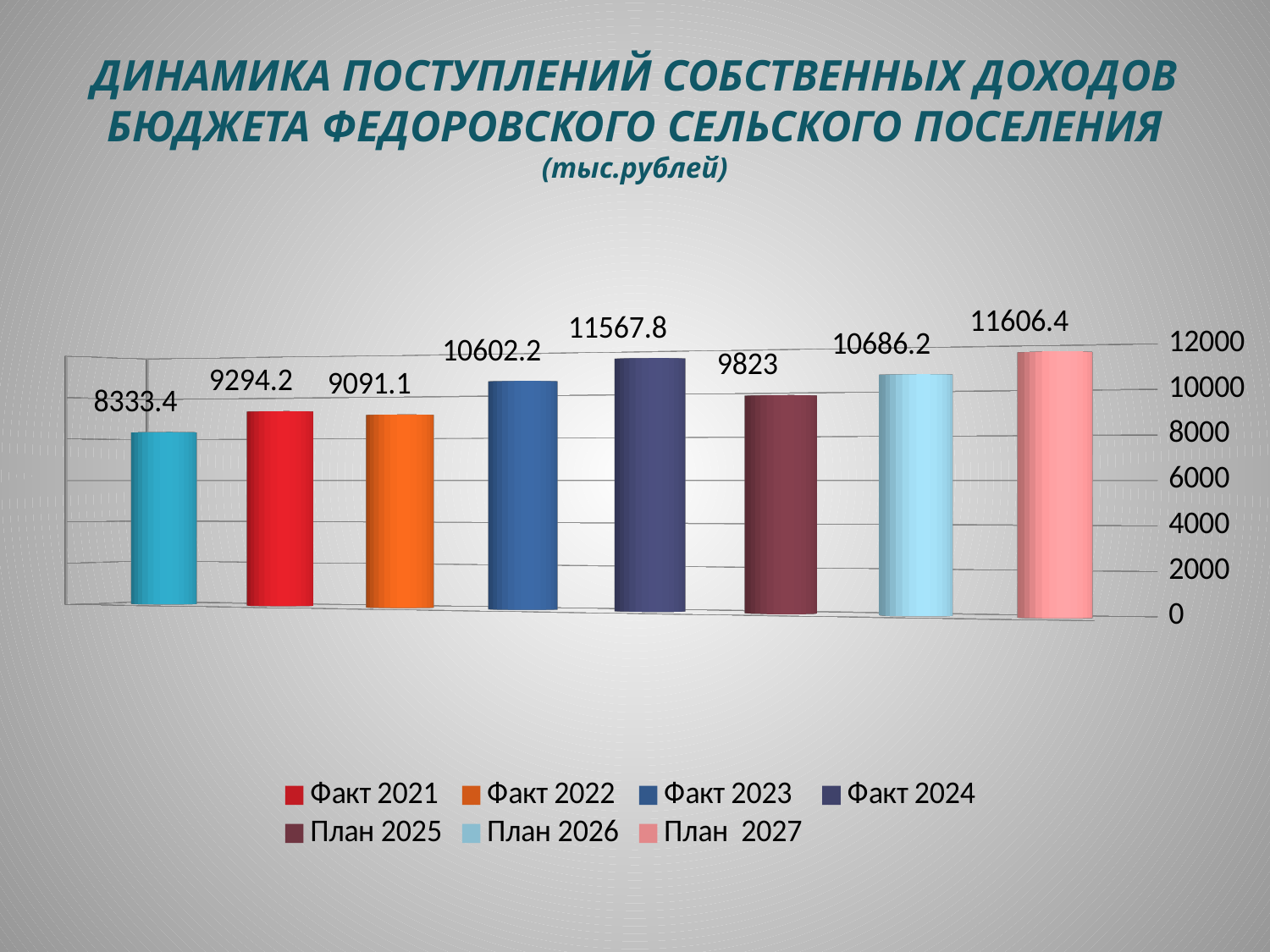
What is the value for План 2025? 9823 What is the value for Факт 2024? 11567.8 Which legend entry has the highest value? План 2027 What is the difference between Факт 2024 and Факт 2023? 965.6 What kind of chart is shown on the slide? Bar chart What is the value for Факт 2022? 9091.1 How many entries does the legend list? 7 What is the lowest value shown on the chart? 8333.4 What is the difference between План 2027 and План 2026? 920.2 What is the value for План 2027? 11606.4 Which is larger, Факт 2021 or Факт 2022? Факт 2021 How many bars are shown on the chart? 8